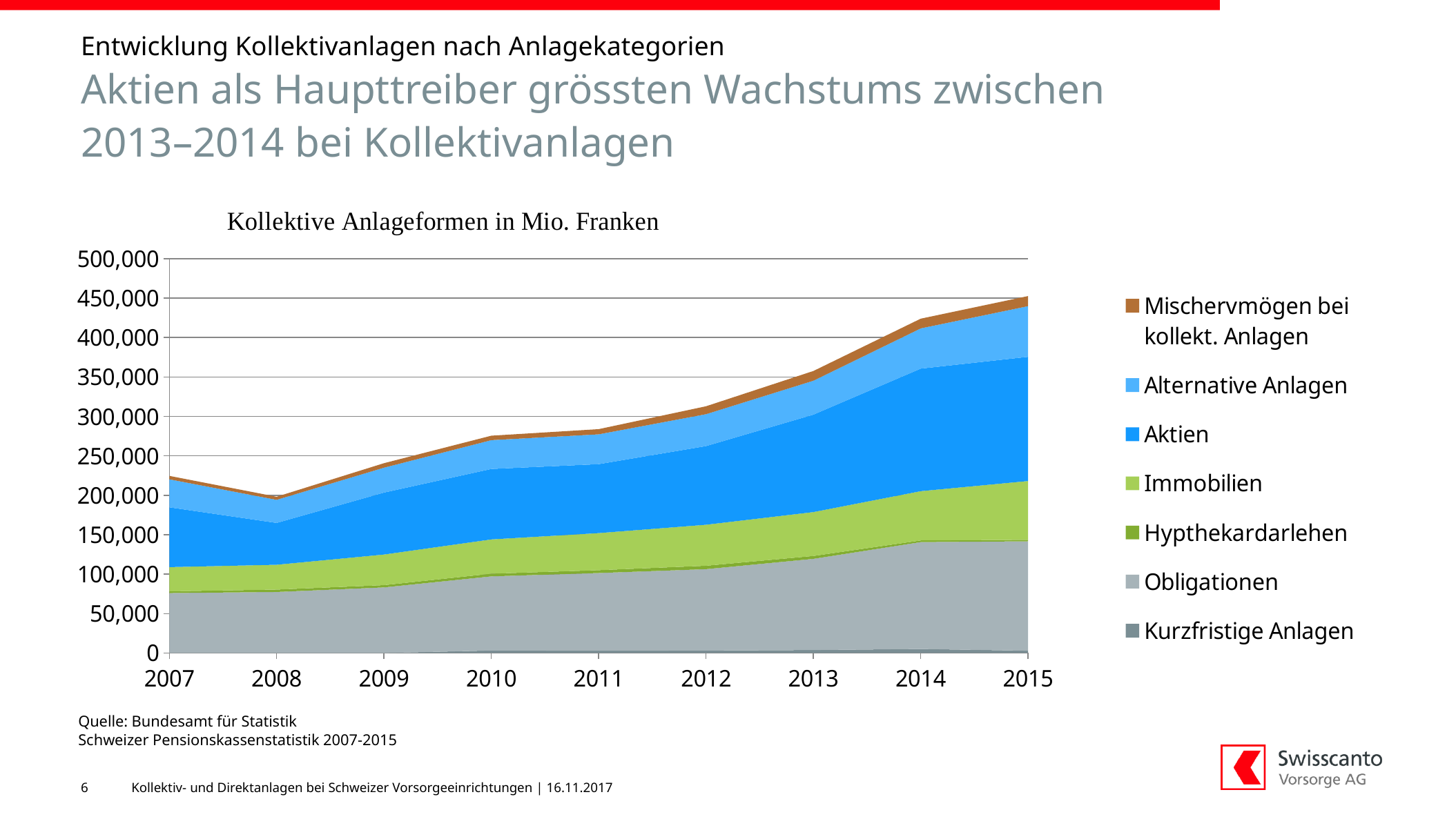
What is the title of the chart? Kollektive Anlageformen in Mio. Franken What kind of chart is shown on the slide? Stacked area chart Which is larger, the total value in 2015 or the total value in 2010? 2015 In which year is the total of all collective investment categories lowest? 2008 How many series does the legend list? 7 Which series is shown at the bottom of the stacked areas, according to the legend? Kurzfristige Anlagen How many years are shown on the x axis? 9 Is the total value in 2011 greater or less than 300,000? less In which year is the total of all collective investment categories highest? 2015 Is the total value in 2014 greater or less than 400,000? greater Is the total value in 2007 greater or less than 200,000? greater Does the total of all categories rise or fall between 2008 and 2015? rise